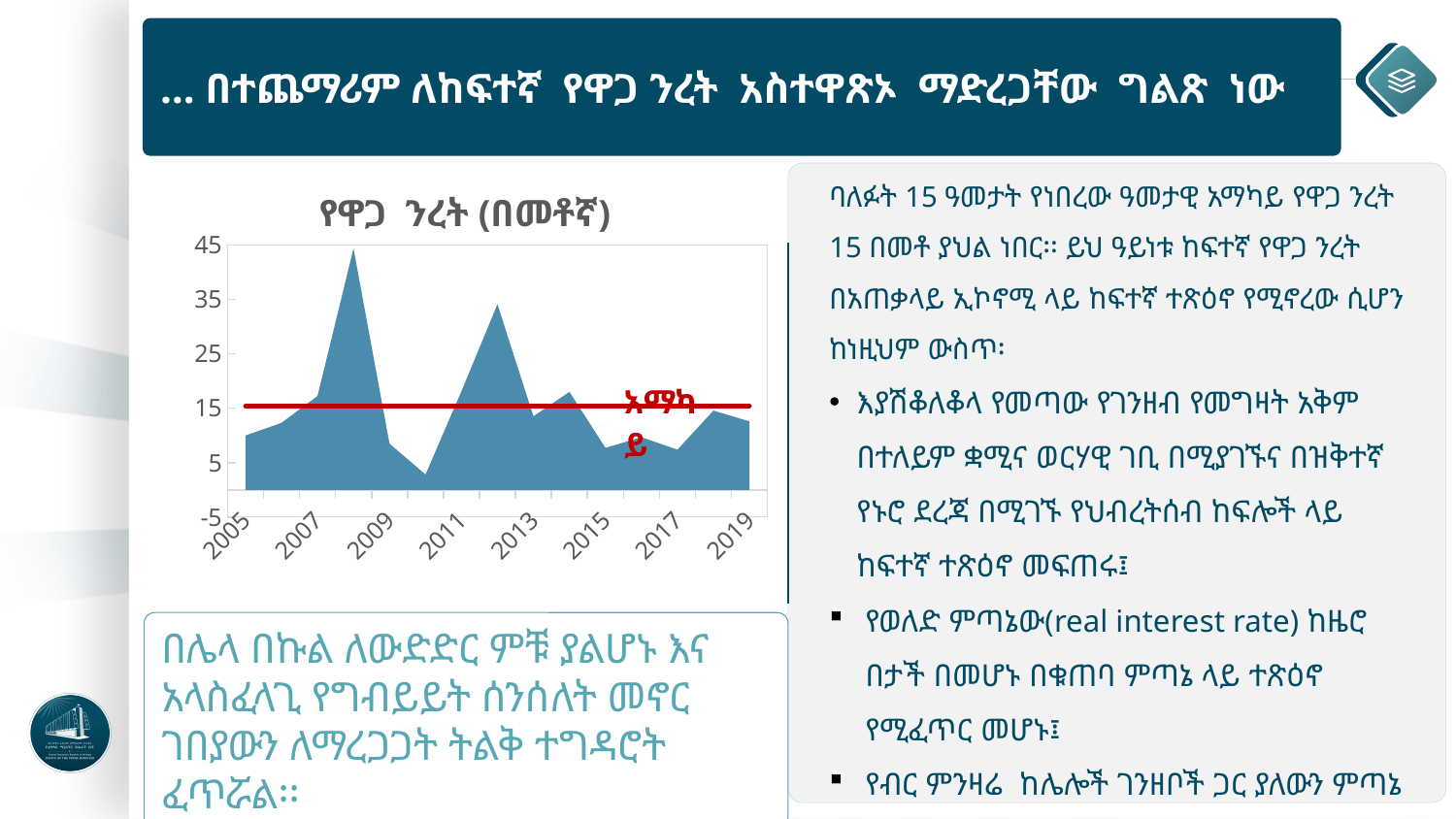
Is the value for 2005 greater or less than 15? less Is the highest value plotted in the chart greater or less than 35? greater Which year has the larger value, 2011 or 2013? 2011 Is the value for 2013 greater or less than 15? less What label is written on the red horizontal line in the chart? አማካይ Does the value rise or fall from 2005 to 2007? rise How many year labels are shown on the x axis of the chart? 8 Which year has the larger value, 2007 or 2009? 2007 What is the title of the chart? የዋጋ ንረት (በመቶኛ) What kind of chart is shown on the slide? area chart